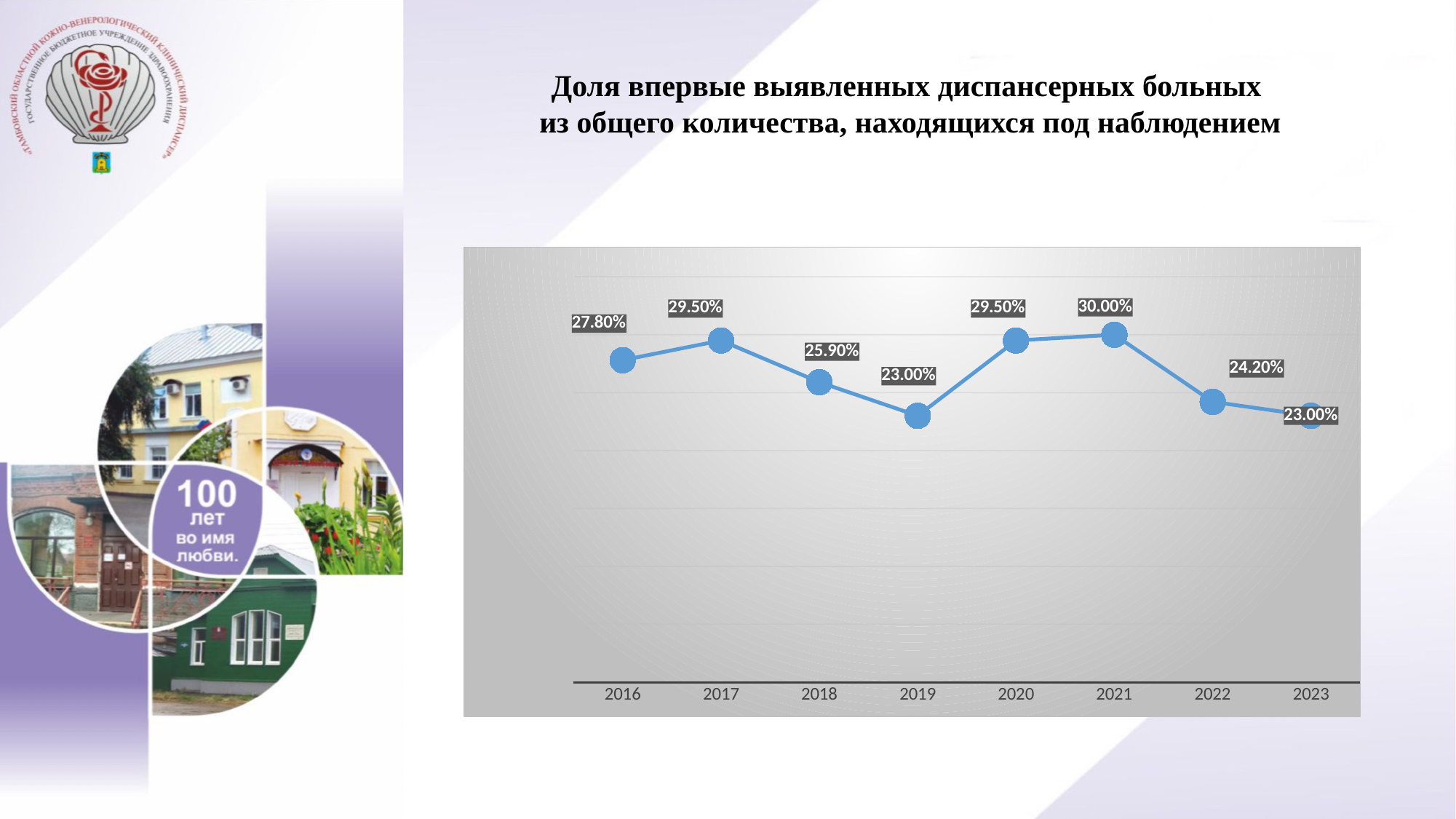
Which is larger, the value for 2020 or the value for 2022? 2020 What kind of chart is shown on the slide? Line chart What is the value for 2022? 24.20% What is the value for 2016? 27.80% What is the value for 2021? 30.00% Which year has the highest value? 2021 How many years are plotted on the chart? 8 Does the value rise or fall from 2021 to 2023? Fall What is the value for 2018? 25.90% What is the difference between the values for 2021 and 2019? 7.00% What is the difference between the values for 2017 and 2016? 1.70% Which two years share the value 23.00%? 2019 and 2023